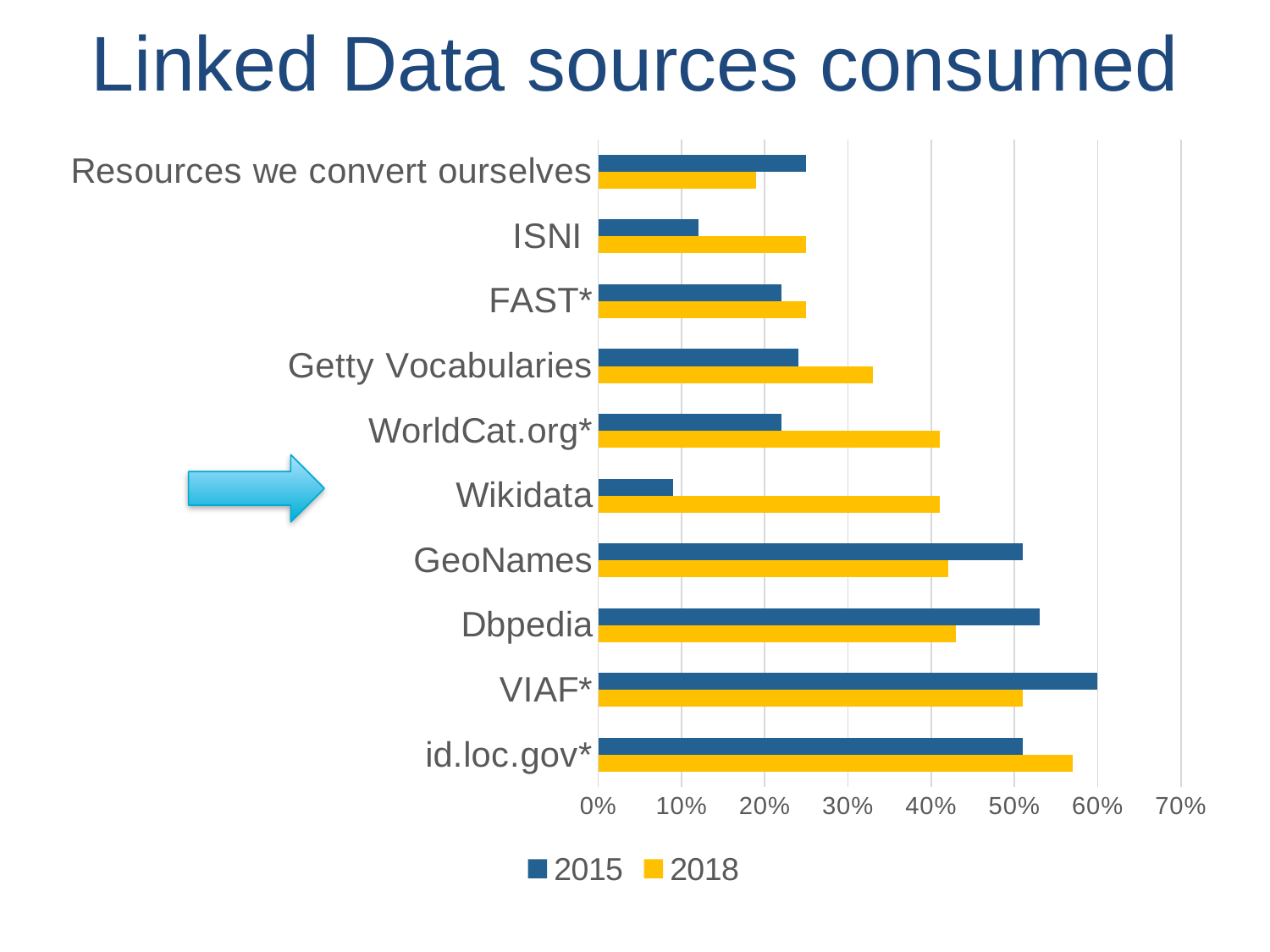
For Wikidata, which year has the larger value, 2015 or 2018? 2018 Which data source has the lowest value for 2018? Resources we convert ourselves How many data sources (categories) are listed on the chart? 10 How many series does the legend list? 2 Is the 2018 value for Wikidata greater or less than 30%? greater Is the 2015 value for VIAF* greater or less than 50%? greater Which data source has the highest value for 2018? id.loc.gov* What are the two series named in the legend? 2015 and 2018 Is the 2015 value for ISNI greater or less than 20%? less What kind of chart is shown on the slide? Bar chart Which data source has the lowest value for 2015? Wikidata Which data source has the highest value for 2015? VIAF*